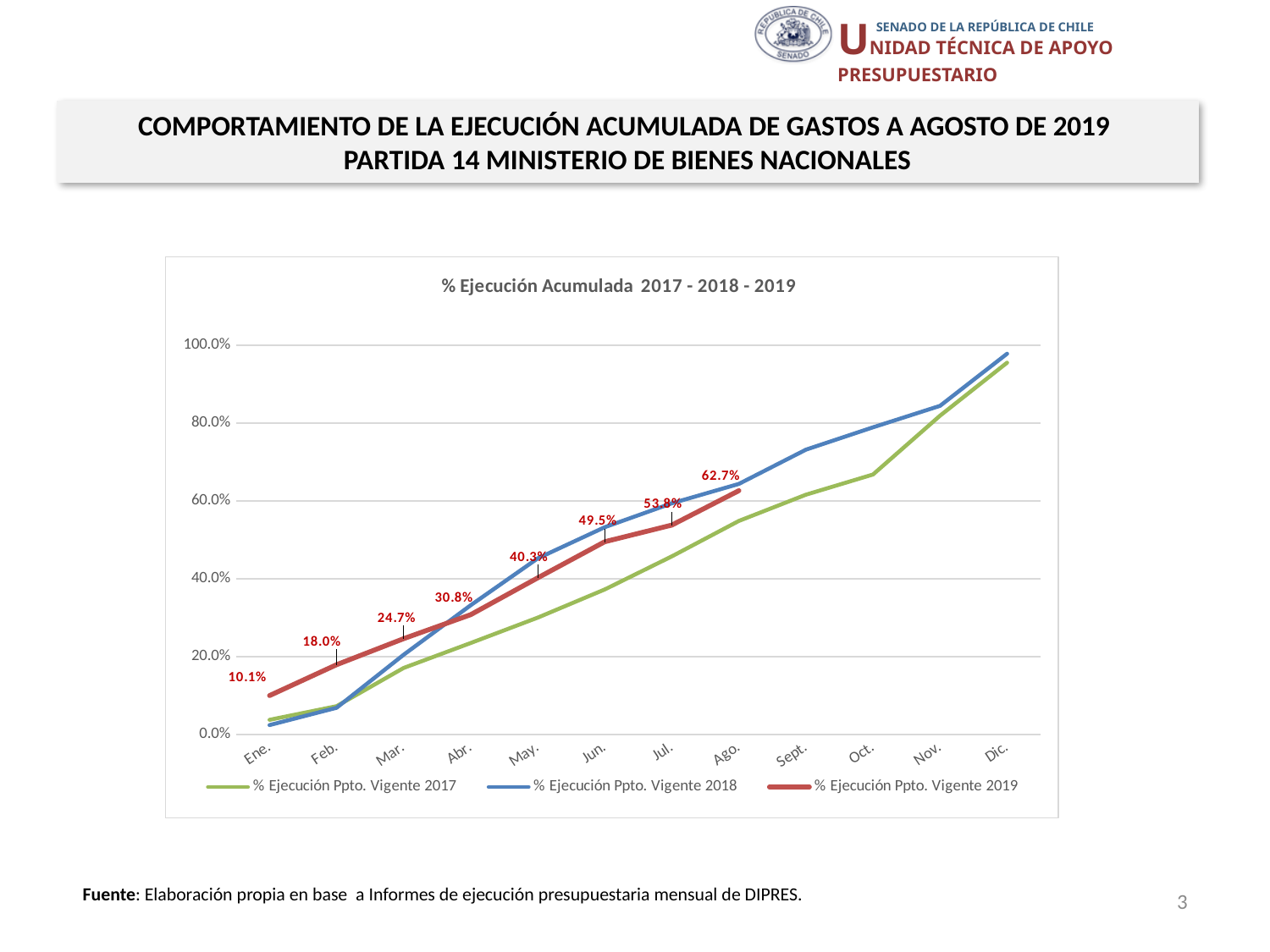
What is the value of % Ejecución Ppto. Vigente 2019 for May.? 40.3% What is the title of the chart? % Ejecución Acumulada 2017 - 2018 - 2019 Is the value for % Ejecución Ppto. Vigente 2017 in Oct. greater or less than 80%? less What is the value of % Ejecución Ppto. Vigente 2019 for Ago.? 62.7% What is the difference between the 2019 values for Feb. and Ene.? 7.9% How many months are shown on the x axis? 12 What is the difference between the 2019 values for Ago. and Jul.? 8.9% How many series does the legend list? 3 Which is larger in Ene., the value for 2019 or the value for 2018? 2019 What kind of chart is shown on the slide? Line chart What is the value of % Ejecución Ppto. Vigente 2019 for Ene.? 10.1% Do the values of % Ejecución Ppto. Vigente 2019 rise or fall from Ene. to Ago.? Rise